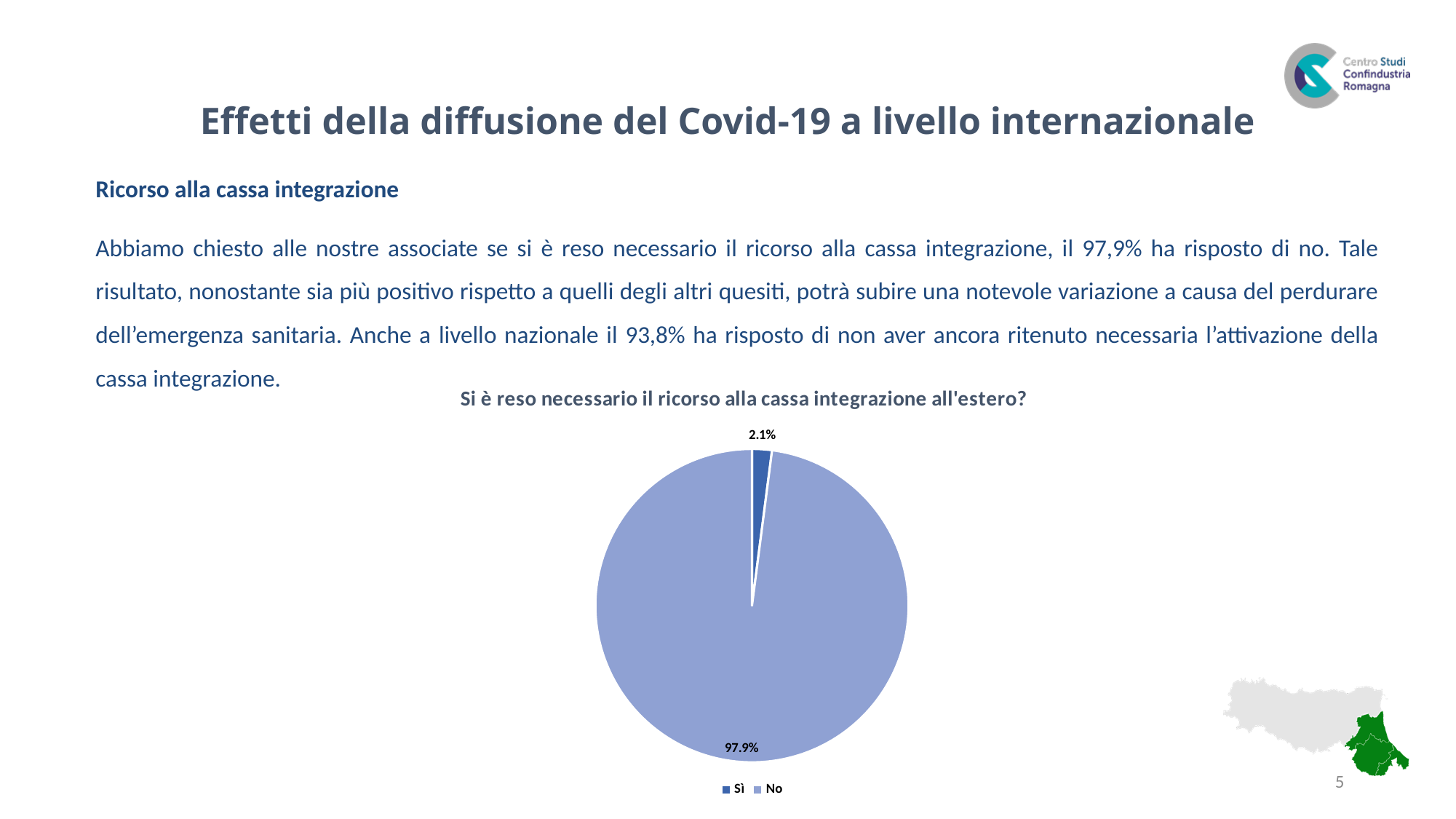
Which category has the largest slice of the pie? No Which legend entry is shown in the darker blue colour? Sì What kind of chart is shown on the slide? pie chart What is the title of the chart? Si è reso necessario il ricorso alla cassa integrazione all'estero? What share of the pie is labelled "No"? 97.9% Which category has the smallest slice of the pie? Sì Which slice is larger, "Sì" or "No"? No How many slices does the pie chart have? 2 What share of the pie is labelled "Sì"? 2.1% What is the difference in percentage points between the "No" slice and the "Sì" slice? 95.8 How many entries does the legend list? 2